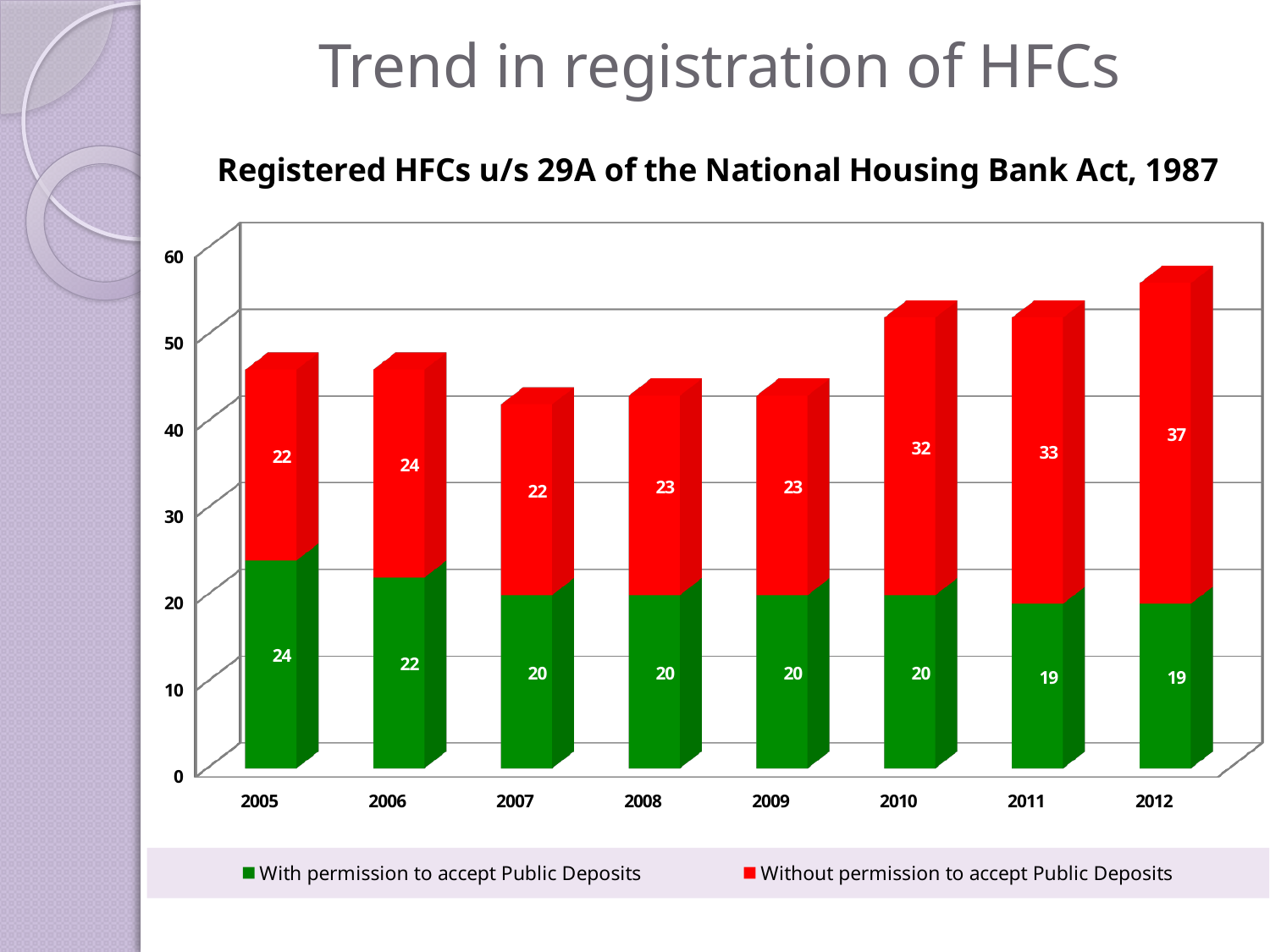
What kind of chart is shown on the slide? Stacked bar chart How many series does the legend list? 2 What is the difference between the 'Without permission to accept Public Deposits' values for 2012 and 2005? 15 Which year has the highest value for 'Without permission to accept Public Deposits'? 2012 Which year has the highest value for 'With permission to accept Public Deposits'? 2005 What is the value for 'Without permission to accept Public Deposits' in 2012? 37 How many years are shown on the x axis? 8 What is the total of the stacked bar for 2012? 56 What is the value for 'Without permission to accept Public Deposits' in 2010? 32 Which is larger: 'Without permission to accept Public Deposits' in 2011 or in 2009? 2011 What is the total of the stacked bar for 2007? 42 What is the value for 'With permission to accept Public Deposits' in 2005? 24